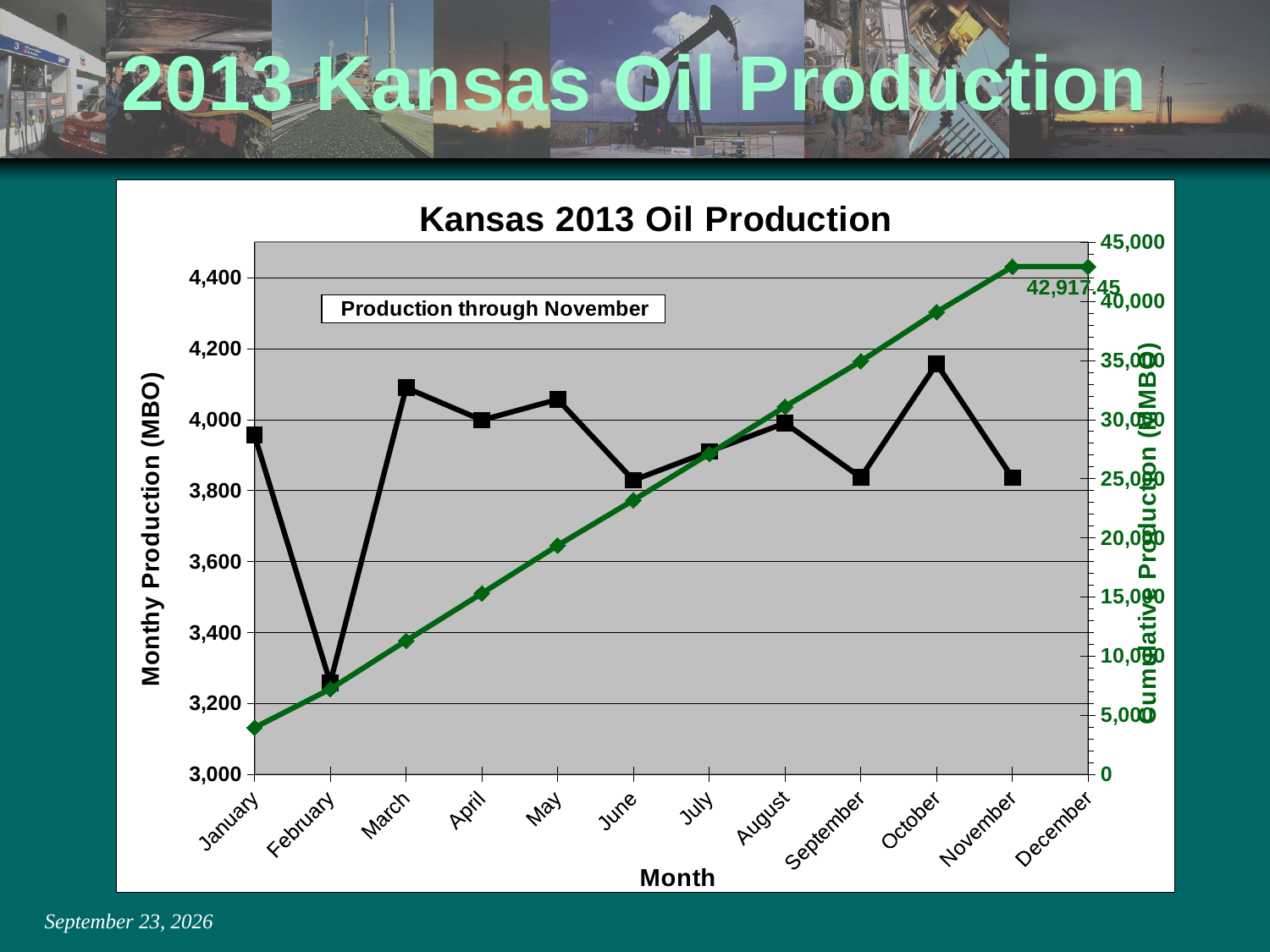
Is the monthly production for March greater or less than 4,000? greater Is the monthly production for February greater or less than 3,400? less What is the title of the x axis? Month What cumulative production value is labelled at December? 42,917.45 Does the cumulative production line rise or fall from January to November? rise Is the cumulative production for January greater or less than 5,000? less What kind of chart is shown on the slide? line chart How many months have a monthly production point plotted? 11 Which month has the lowest monthly production? February How many months are listed along the x axis? 12 Which is larger, the monthly production for January or for February? January What is the title of the chart? Kansas 2013 Oil Production